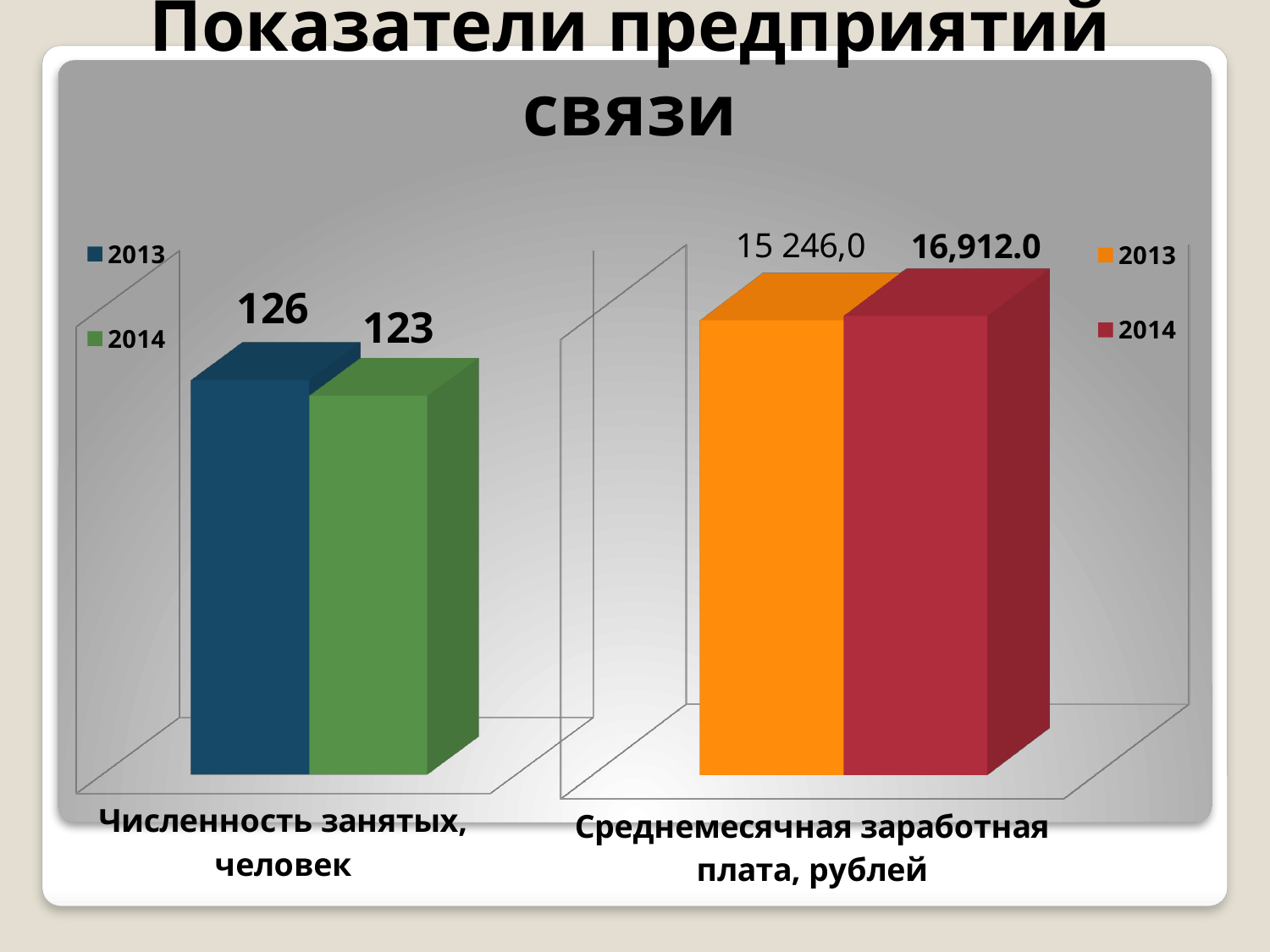
In the right chart (Среднемесячная заработная плата, рублей), what is the value for 2014? 16,912.0 In the right chart (Среднемесячная заработная плата, рублей), what is the value for 2013? 15 246,0 In the left chart (Численность занятых, человек), do the values rise or fall from 2013 to 2014? fall In the left chart (Численность занятых, человек), what is the value for 2013? 126 In the right chart (Среднемесячная заработная плата, рублей), is the value for 2014 larger or smaller than the value for 2013? larger In the right chart, what colour is the bar for 2014? red In the right chart (Среднемесячная заработная плата, рублей), which year has the lower value? 2013 What kind of chart is the right chart (Среднемесячная заработная плата, рублей)? bar chart In the left chart (Численность занятых, человек), what is the value for 2014? 123 How many series does the legend of the left chart list? 2 In the left chart (Численность занятых, человек), which year has the higher value? 2013 In the left chart (Численность занятых, человек), what is the difference between the 2013 and 2014 values? 3